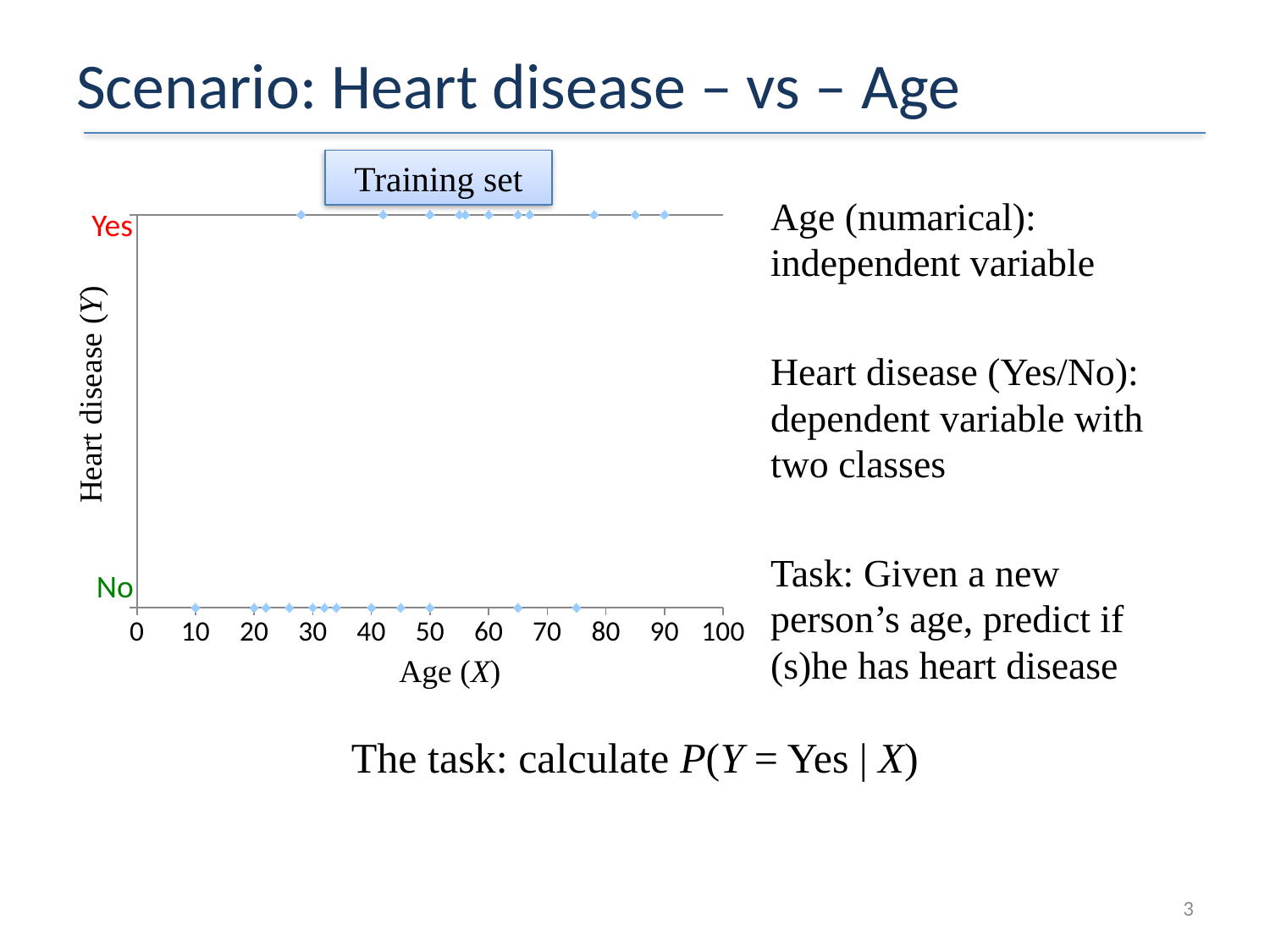
Are there any Yes points at ages below 20 on the chart? No Is the rightmost point in the Yes row at an age greater or less than 80? greater Which row, Yes or No, has its rightmost point at the higher age? Yes Which row, Yes or No, has its leftmost point at the lower age? No What kind of chart is shown on the slide? scatter plot What is the title shown above the chart? Training set Is the rightmost point in the No row at an age greater or less than 80? less What are the two categories labelled on the y axis of the chart? Yes and No What is the highest tick value shown on the x axis (Age) of the chart? 100